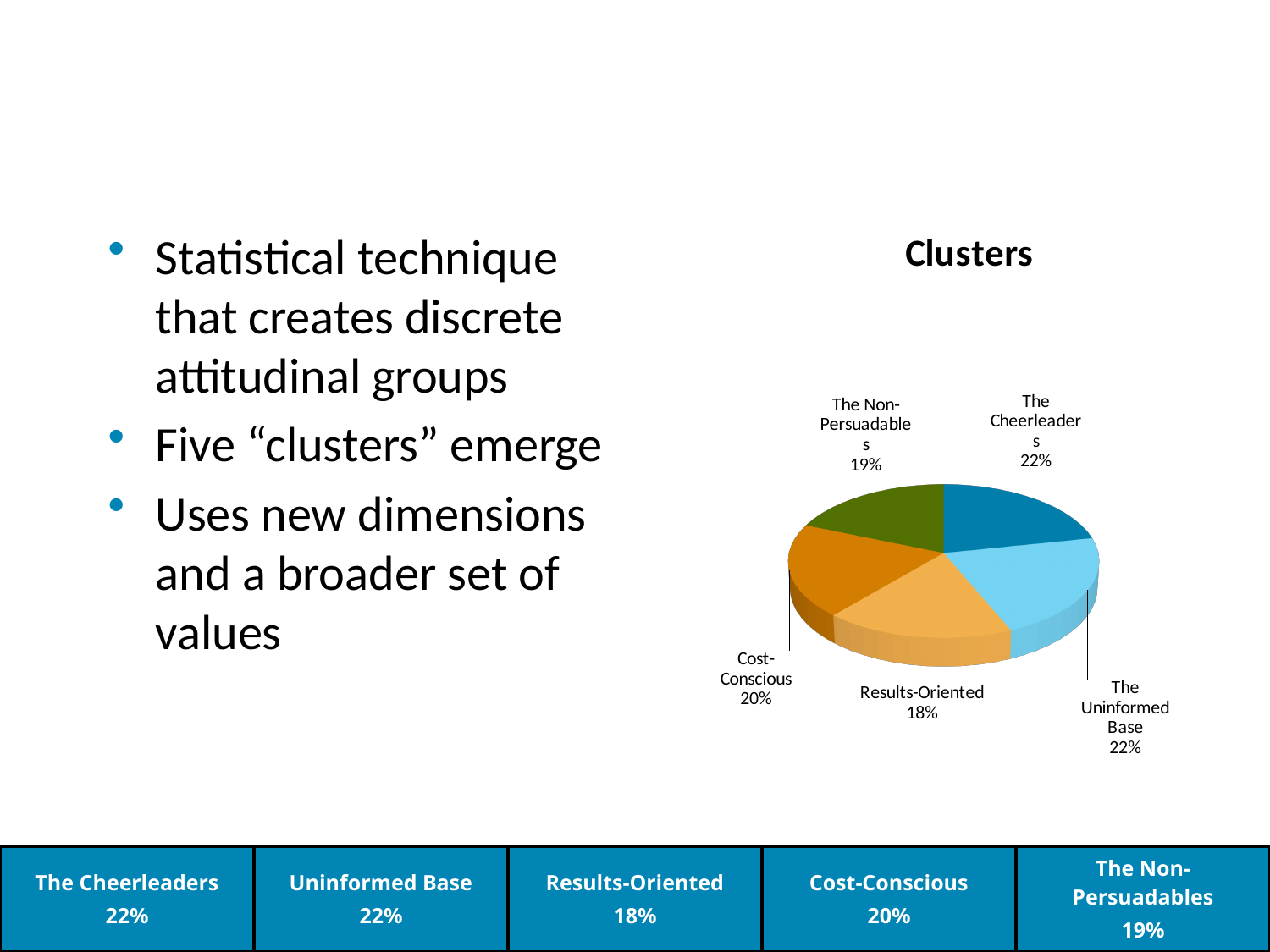
What is the difference between the shares of Cost-Conscious and Results-Oriented? 2% What share of the pie is The Non-Persuadables? 19% How many slices does the pie chart have? 5 What is the difference between the shares of The Cheerleaders and The Non-Persuadables? 3% What is the title of the chart? Clusters Which is larger, the share for Cost-Conscious or the share for The Non-Persuadables? Cost-Conscious What share of the pie is The Cheerleaders? 22% What share of the pie is Cost-Conscious? 20% What kind of chart is shown on the slide? pie chart Which cluster has the smallest share of the pie? Results-Oriented